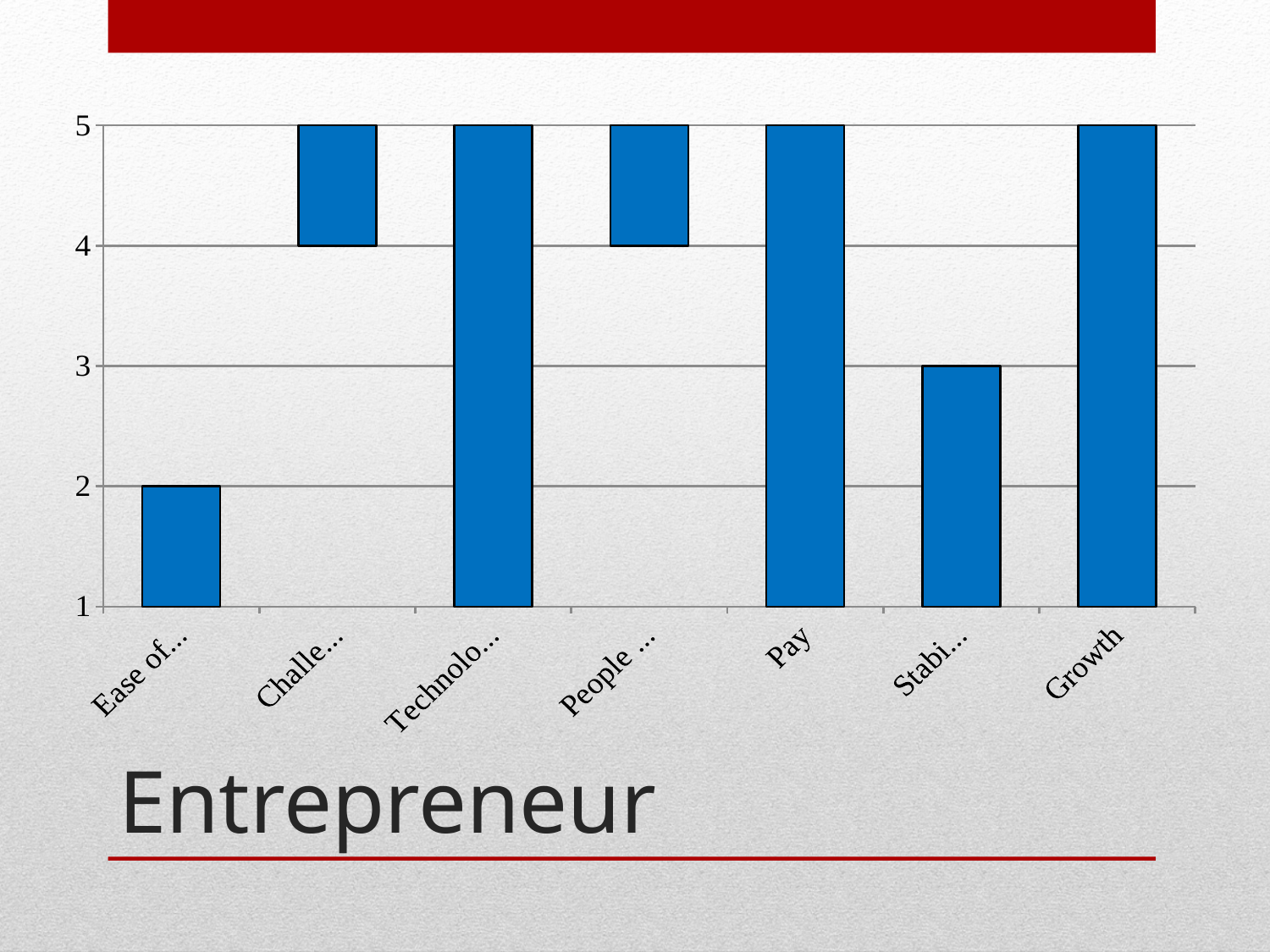
What value does the bar for Pay reach? 5 What value does the bar for Growth reach? 5 What kind of chart is shown on the slide? bar chart What is the title text shown below the chart? Entrepreneur What value does the bar labelled 'Stabi...' reach? 3 Which bar has the lowest top value? Ease of... Which is larger, the value for Pay or the value for 'Stabi...'? Pay What is the highest value shown on the vertical axis? 5 How many bars does the chart have? 7 What is the difference between the value for Pay and the value for 'Stabi...'? 2 Is the value for 'Stabi...' greater or less than 4? less What value does the first bar on the left (labelled 'Ease of...') reach? 2